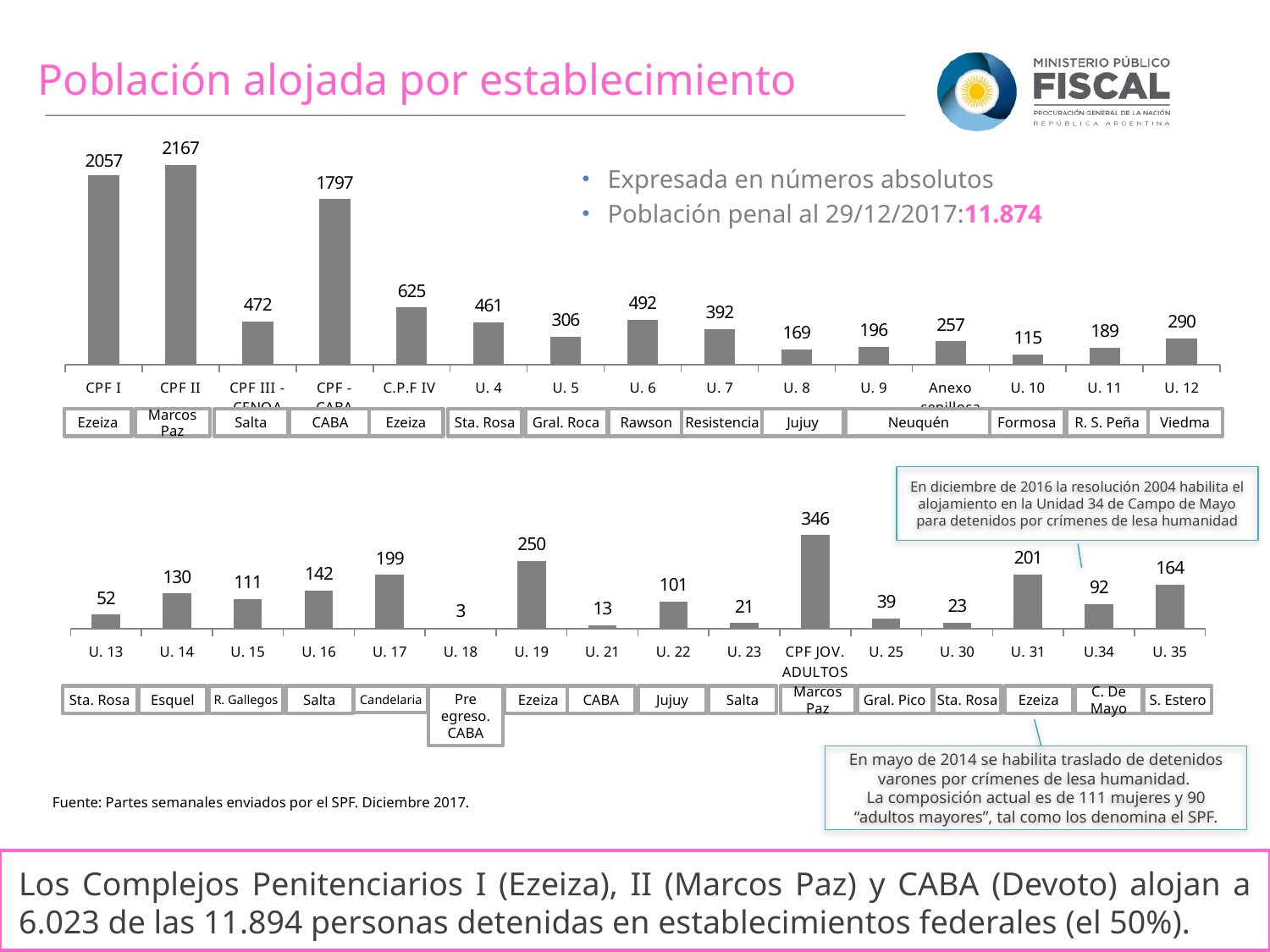
In the bottom chart, what is the value for U. 19? 250 In the bottom chart, which category has the highest value? CPF JOV. ADULTOS In the top chart, what is the value for U. 6? 492 In the bottom chart, what is the difference between the values for U. 31 and U. 17? 2 In the top chart, what is the difference between the values for CPF II and CPF I? 110 In the top chart, which category has the highest value? CPF II In the top chart, which category has the lowest value? U. 10 How many categories are shown in the top chart? 15 What type of chart is the bottom chart? Bar chart In the top chart, which is larger, the value for C.P.F IV or the value for U. 4? C.P.F IV In the top chart, what is the value for CPF II? 2167 In the bottom chart, which category has the lowest value? U. 18